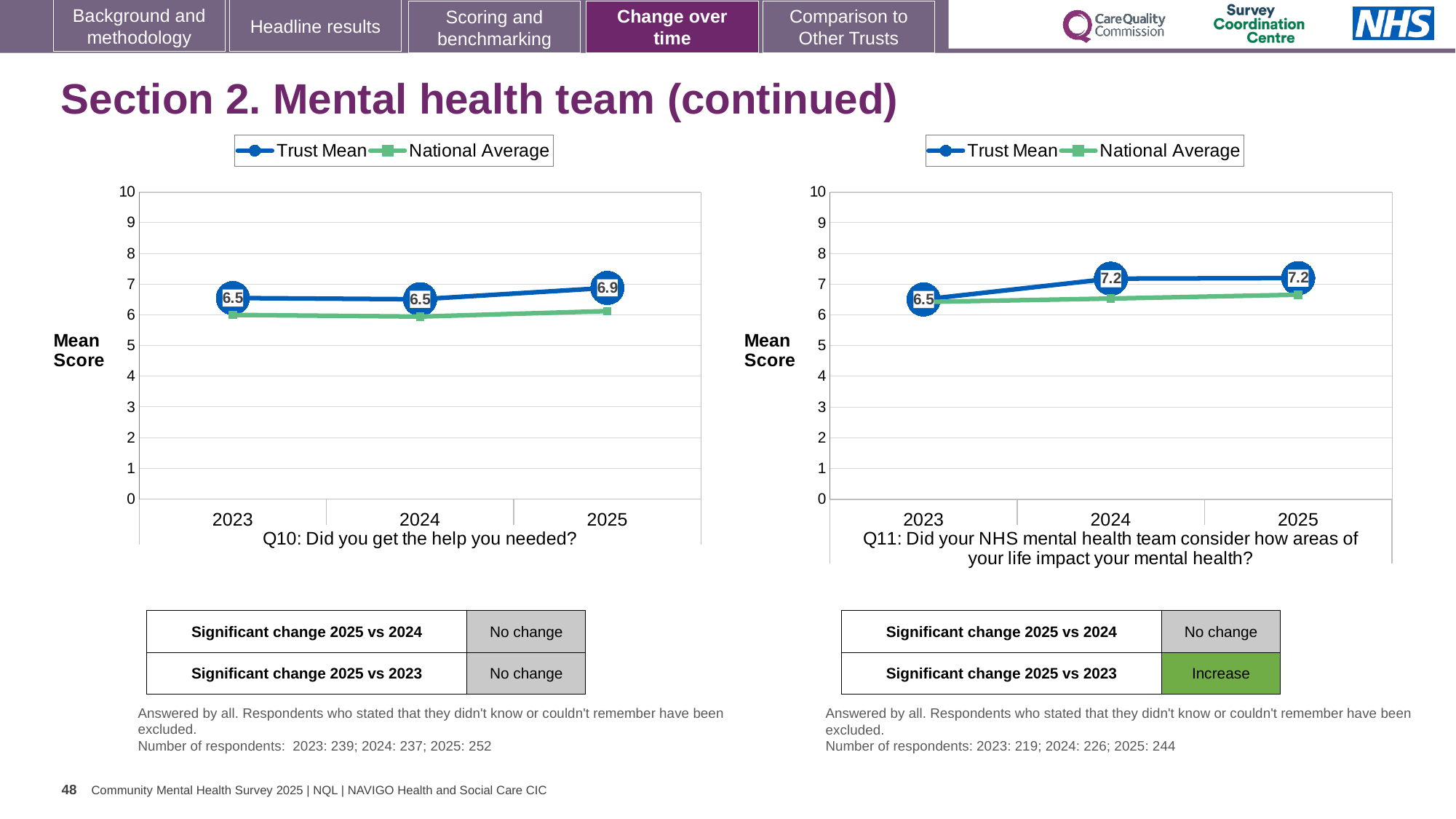
How many years are plotted on the x axis of the Q11 chart on the right? 3 In the Q10 chart on the left, by how much did the Trust Mean change from 2024 to 2025? 0.4 In the Q10 chart on the left, is the National Average for 2023 greater or less than 7? less In the Q11 chart on the right, what is the Trust Mean for 2024? 7.2 In the Q10 chart on the left, what is the Trust Mean for 2025? 6.9 In the Q10 chart on the left, is the Trust Mean for 2025 larger than the Trust Mean for 2023? Yes How many series does the legend of the Q10 chart on the left list? 2 In the Q11 chart on the right, what is the Trust Mean for 2023? 6.5 In the Q11 chart on the right, what is the difference between the Trust Mean in 2023 and in 2025? 0.7 In the Q10 chart on the left, what is the Trust Mean for 2023? 6.5 In the Q11 chart on the right, which year has the lowest Trust Mean? 2023 What type of chart is the Q11 chart on the right? Line chart